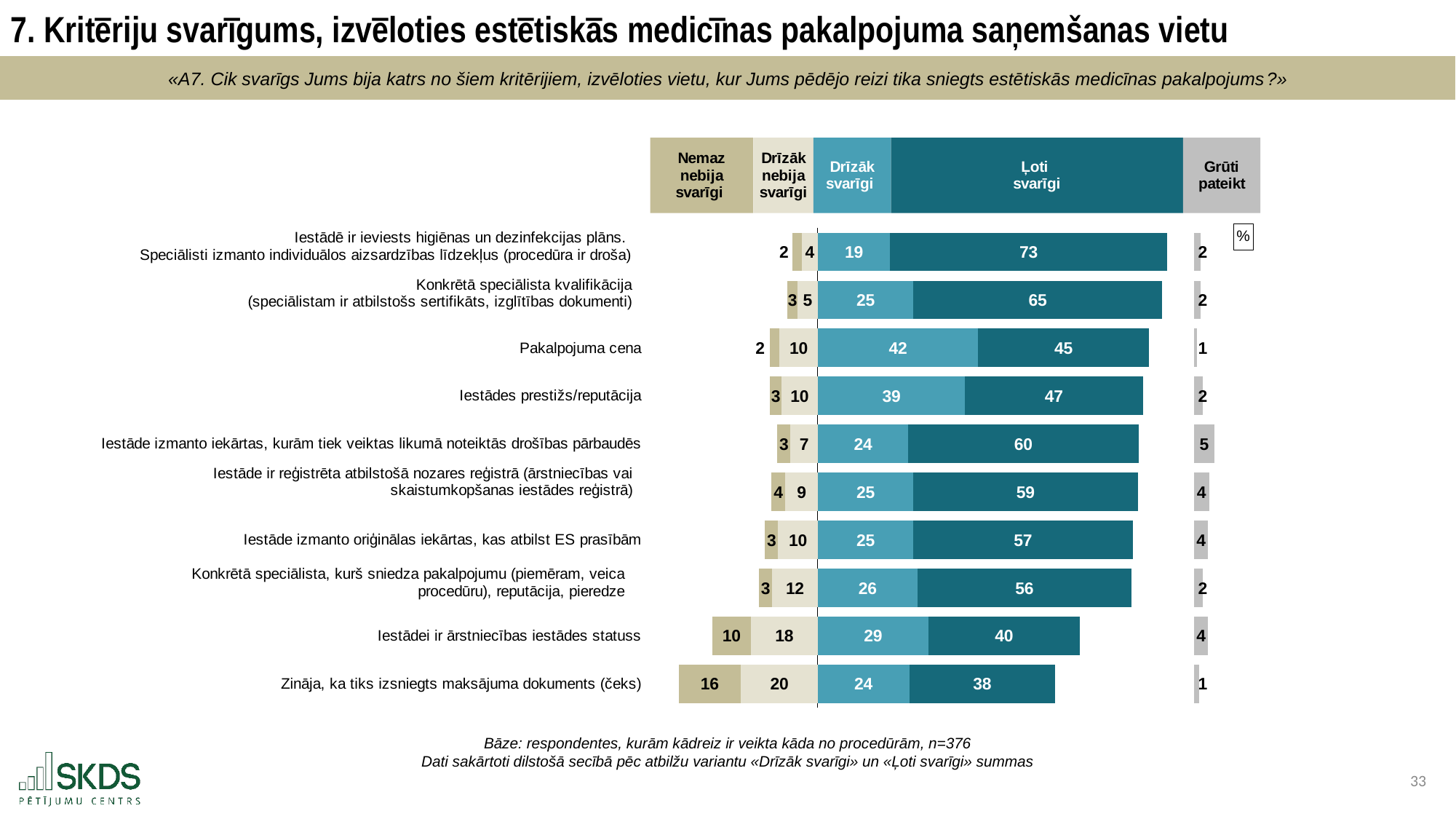
Which category has the lowest value for "Ļoti svarīgi"? Zināja, ka tiks izsniegts maksājuma dokuments (čeks) How many categories (criteria) are shown in the chart? 10 For "Pakalpojuma cena", what is the difference between the "Ļoti svarīgi" value and the "Drīzāk svarīgi" value? 3 For "Konkrētā speciālista kvalifikācija (speciālistam ir atbilstošs sertifikāts, izglītības dokumenti)", what is the combined total of "Drīzāk svarīgi" and "Ļoti svarīgi"? 90 Which has the larger "Ļoti svarīgi" value: "Iestādei ir ārstniecības iestādes statuss" or "Zināja, ka tiks izsniegts maksājuma dokuments (čeks)"? Iestādei ir ārstniecības iestādes statuss Which category has the highest value for "Ļoti svarīgi"? Iestādē ir ieviests higiēnas un dezinfekcijas plāns. Speciālisti izmanto individuālos aizsardzības līdzekļus (procedūra ir droša) Which category has the highest value for "Nemaz nebija svarīgi"? Zināja, ka tiks izsniegts maksājuma dokuments (čeks) What is the value for "Grūti pateikt" for the category "Iestāde izmanto iekārtas, kurām tiek veiktas likumā noteiktās drošības pārbaudēs"? 5 How many series does the chart legend list? 5 What kind of chart is shown on the slide? Stacked bar chart What is the value for "Drīzāk svarīgi" for the category "Iestādes prestižs/reputācija"? 39 What is the value for "Ļoti svarīgi" for the category "Pakalpojuma cena"? 45